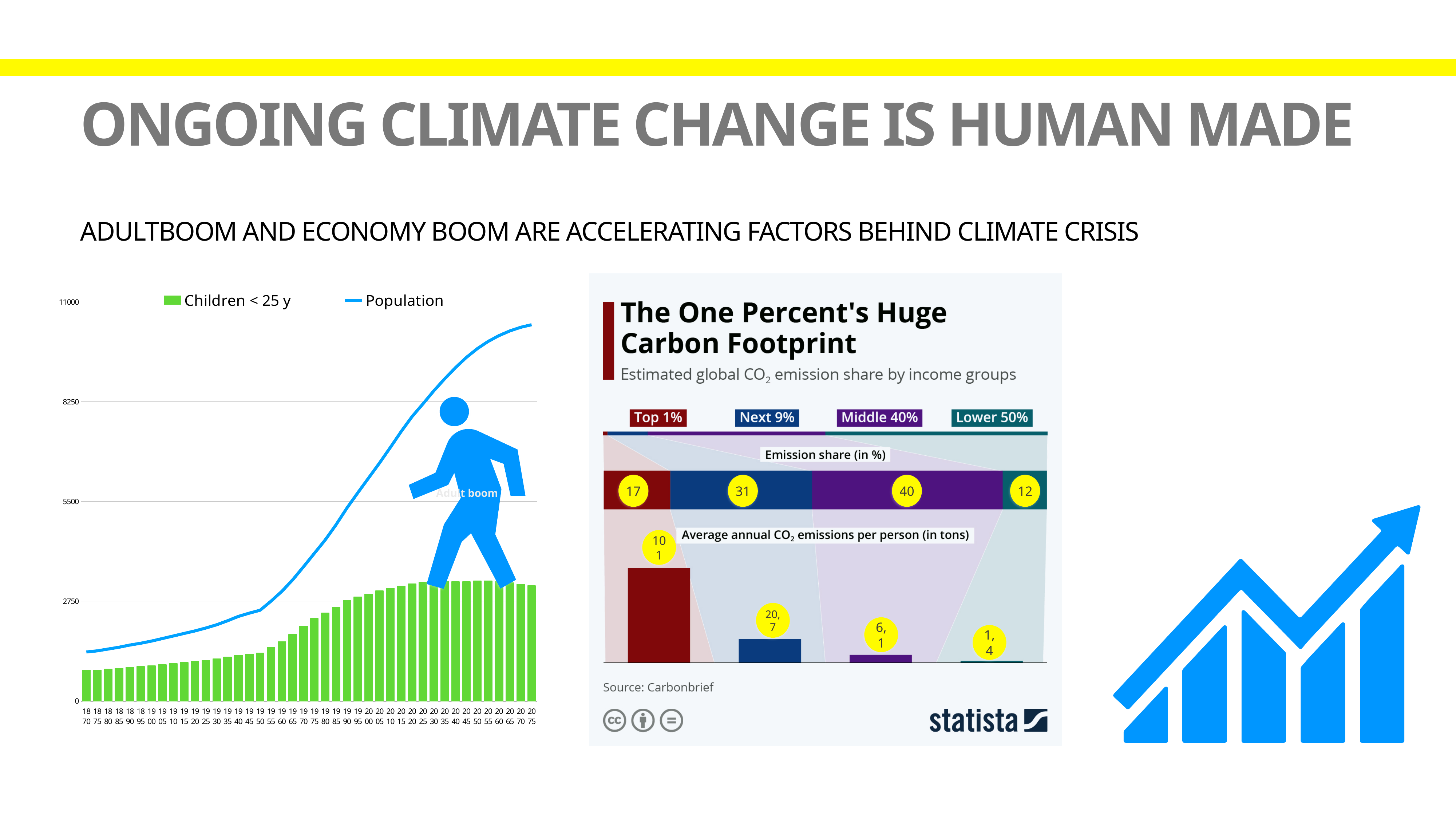
In the chart titled 'The One Percent's Huge Carbon Footprint', what source is cited? Carbonbrief In the chart titled 'The One Percent's Huge Carbon Footprint', which income group has the higher average annual CO2 emissions per person, Top 1% or Next 9%? Top 1% In the chart on the left of the slide, does the Population line rise or fall from 1870 to 2075? rise In the chart titled 'The One Percent's Huge Carbon Footprint', how many income groups are shown? 4 In the chart titled 'The One Percent's Huge Carbon Footprint', what is the emission share (in %) for the Next 9%? 31 In the chart titled 'The One Percent's Huge Carbon Footprint', what is the emission share (in %) for the Top 1%? 17 In the chart on the left of the slide, is the Population value for 2075 greater or less than 8250? greater In the chart titled 'The One Percent's Huge Carbon Footprint', what is the average annual CO2 emissions per person (in tons) for the Lower 50%? 1,4 In the chart on the left of the slide, how many series does the legend list? 2 In the chart titled 'The One Percent's Huge Carbon Footprint', which income group has the lowest emission share? Lower 50% In the chart titled 'The One Percent's Huge Carbon Footprint', what is the difference in emission share between the Middle 40% and the Lower 50%? 28 In the chart titled 'The One Percent's Huge Carbon Footprint', which income group has the highest emission share? Middle 40%